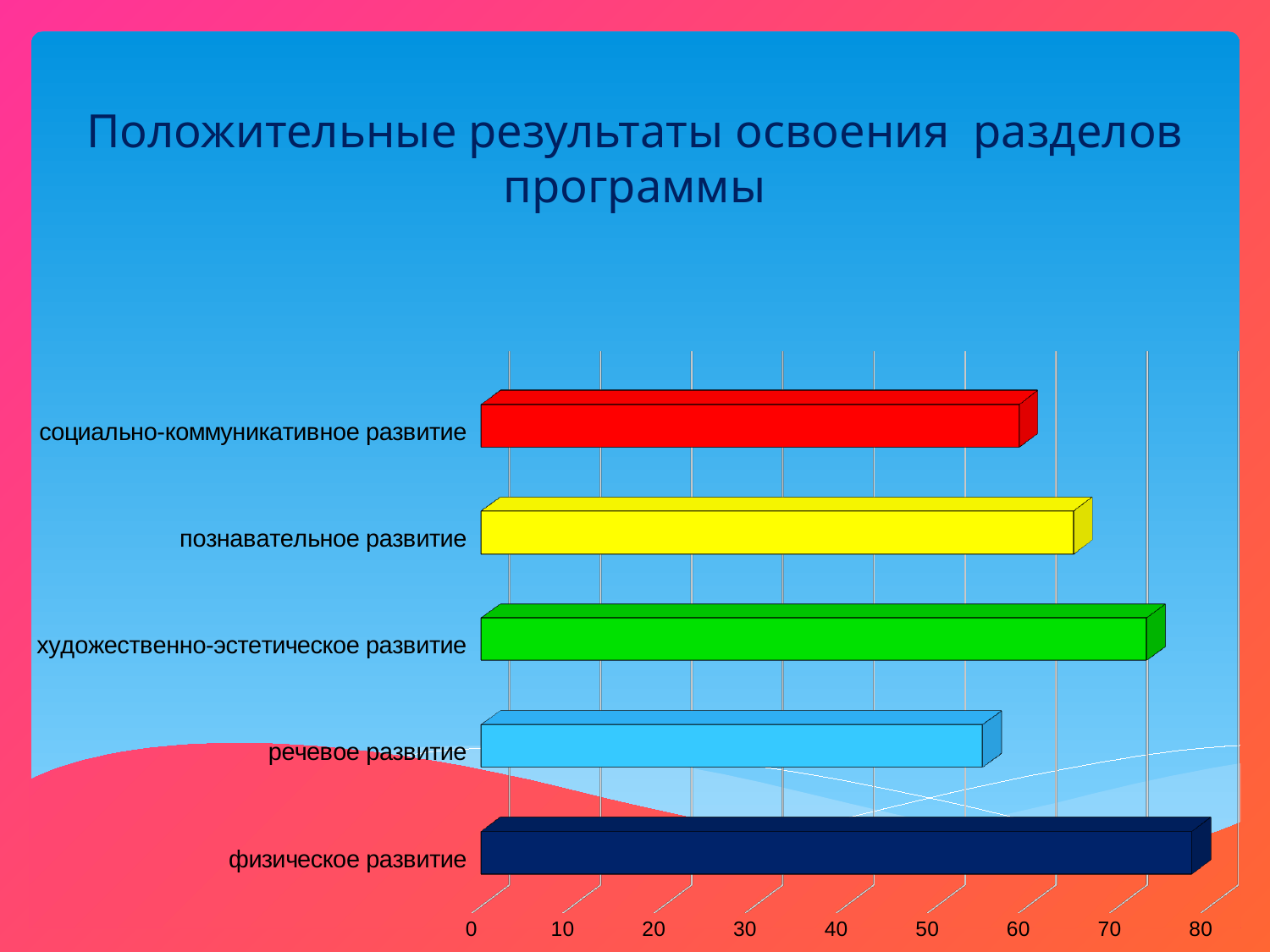
Is the value for художественно-эстетическое развитие greater or less than 70? greater Is the value for социально-коммуникативное развитие greater or less than 50? greater Which category has the lowest value? речевое развитие Is the value for речевое развитие greater or less than 60? less Which is larger, the value for художественно-эстетическое развитие or the value for речевое развитие? художественно-эстетическое развитие Which category has the highest value? физическое развитие What kind of chart is shown on the slide? bar chart How many categories are plotted in the chart? 5 What is the title of the slide containing the chart? Положительные результаты освоения разделов программы Which is larger, the value for познавательное развитие or the value for социально-коммуникативное развитие? познавательное развитие